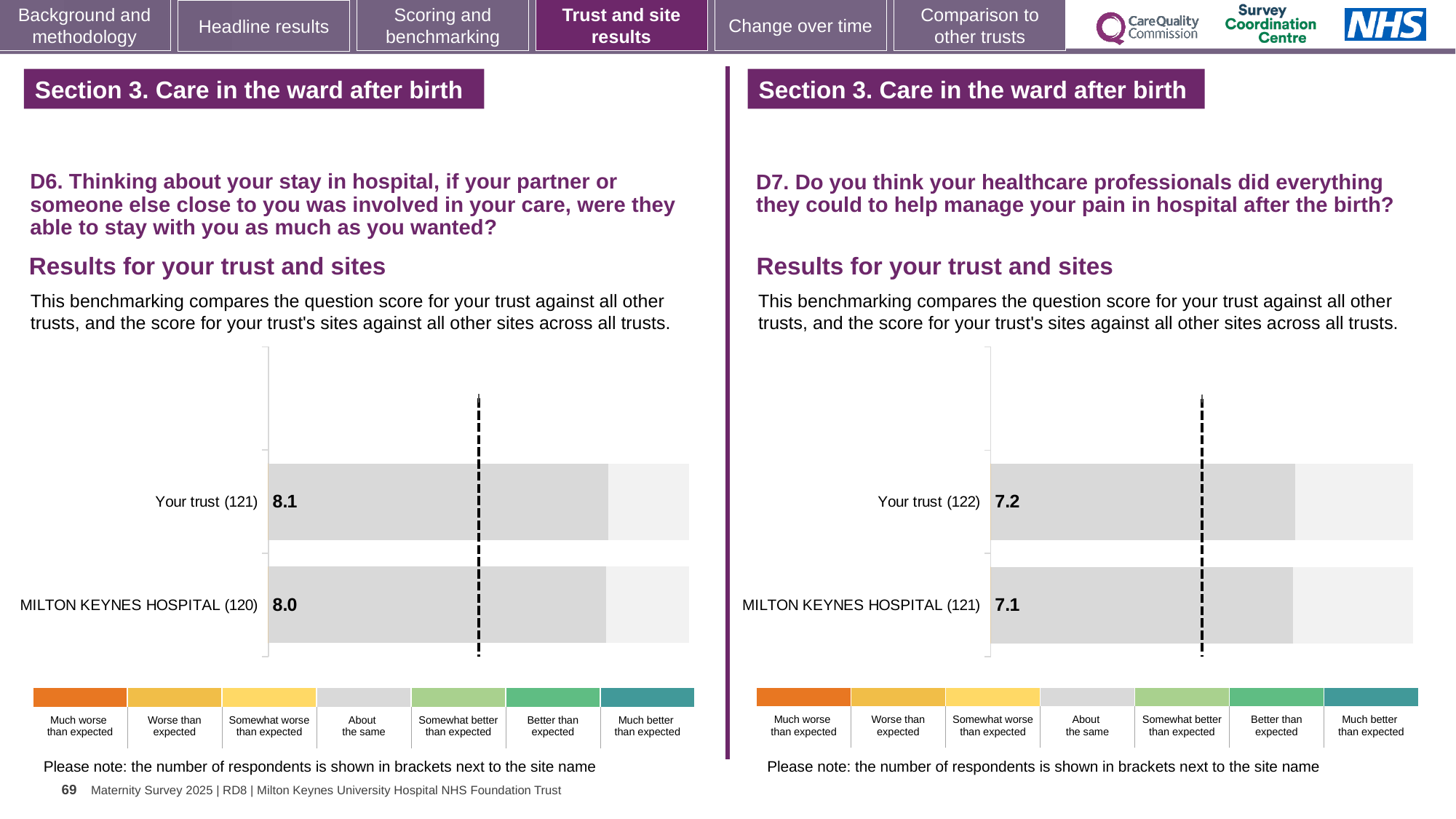
In the D6 chart on the left, which has the higher score, Your trust or MILTON KEYNES HOSPITAL? Your trust In the D6 chart on the left, what is the score for Your trust? 8.1 In the D7 chart on the right, how many respondents are shown in brackets for Your trust? 122 In the D6 chart on the left, what is the score for MILTON KEYNES HOSPITAL? 8.0 How many benchmark categories does the colour legend below the D6 chart list? 7 In the D6 chart on the left, what is the difference between the Your trust score and the MILTON KEYNES HOSPITAL score? 0.1 In the D7 chart on the right, which has the lower score, Your trust or MILTON KEYNES HOSPITAL? MILTON KEYNES HOSPITAL In the D7 chart on the right, what is the score for Your trust? 7.2 In the D7 chart on the right, what is the score for MILTON KEYNES HOSPITAL? 7.1 What kind of chart is used for the D7 results on the right? Bar chart How many bars are plotted in the D6 chart on the left? 2 In the D7 chart on the right, what is the difference between the Your trust score and the MILTON KEYNES HOSPITAL score? 0.1